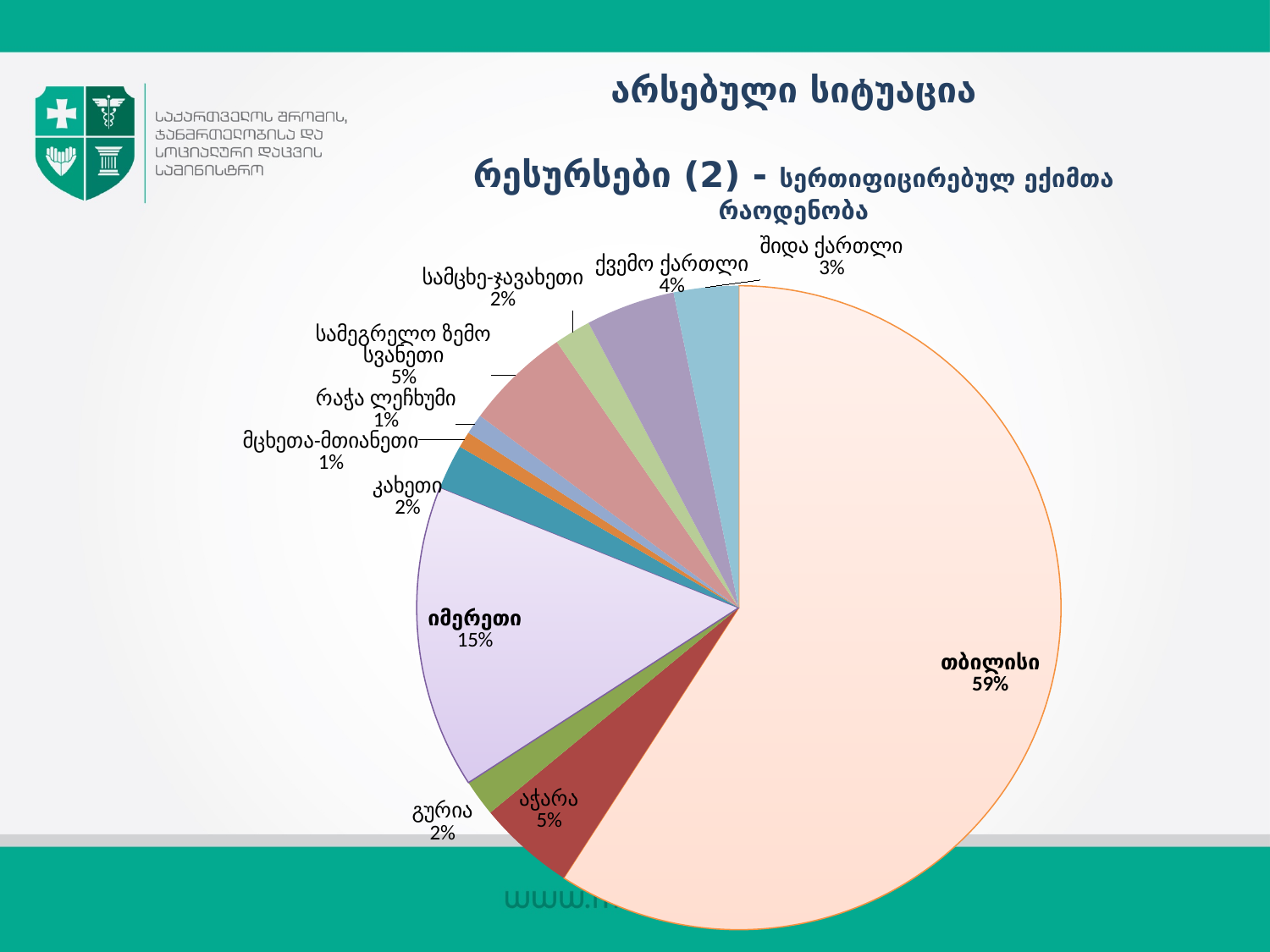
What percentage is shown for ქვემო ქართლი? 4% Which region has the largest slice of the pie? თბილისი What share of the pie does თბილისი hold? 59% Which region has the second-largest slice of the pie? იმერეთი Which is larger, the share for აჭარა or the share for გურია? აჭარა What is the difference in percentage points between თბილისი and იმერეთი? 44 What type of chart is shown on the slide? pie chart What percentage is shown for შიდა ქართლი? 3% How many slices does the pie chart have? 11 What is the title of the chart? რესურსები (2) - სერთიფიცირებულ ექიმთა რაოდენობა What percentage is shown for იმერეთი? 15% Which is larger, the share for ქვემო ქართლი or the share for შიდა ქართლი? ქვემო ქართლი